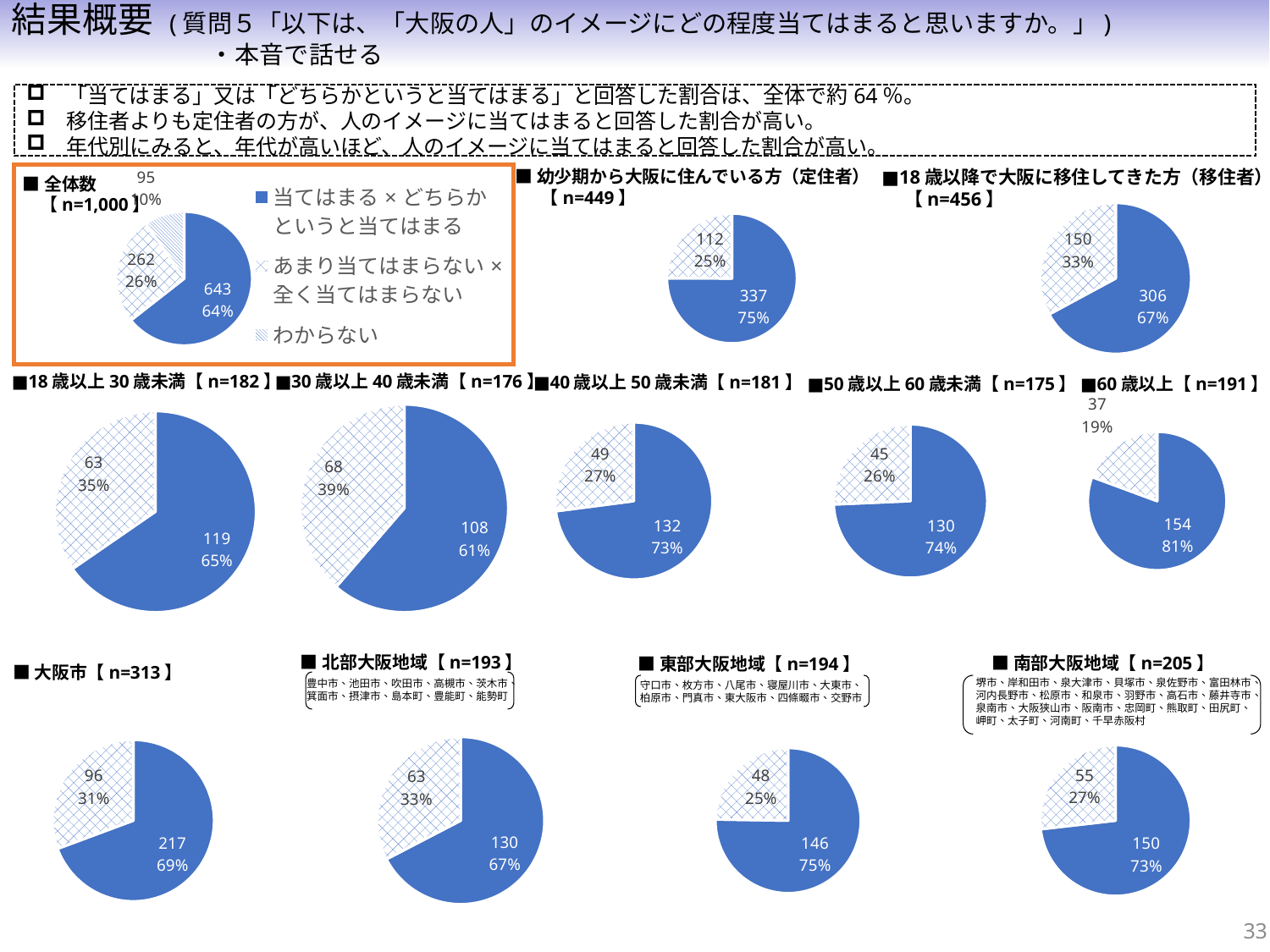
In the 全体数【n=1,000】 chart, what is the value for 当てはまる×どちらかというと当てはまる? 643 In the 大阪市【n=313】 chart, what is the value of the larger slice? 217 How many slices does the 南部大阪地域【n=205】 pie chart have? 2 What kind of chart is used for 幼少期から大阪に住んでいる方（定住者）【n=449】? pie chart In the 東部大阪地域【n=194】 chart, what percentage is shown for the 48 slice? 25% In the 全体数【n=1,000】 chart, what percentage is shown for わからない? 10% In the 幼少期から大阪に住んでいる方（定住者）【n=449】 chart, what percentage is shown for the 337 slice? 75% In the 18歳以降で大阪に移住してきた方（移住者）【n=456】 chart, what is the value of the smaller slice? 150 Which is larger: the 当てはまる share in the 30歳以上40歳未満【n=176】 chart (61%) or in the 50歳以上60歳未満【n=175】 chart (74%)? 50歳以上60歳未満【n=175】 In the 60歳以上【n=191】 chart, what percentage is shown for the 154 slice? 81% What is the difference between the larger slice (132) and the smaller slice (49) in the 40歳以上50歳未満【n=181】 chart? 83 How many entries does the legend in the 全体数【n=1,000】 chart list? 3